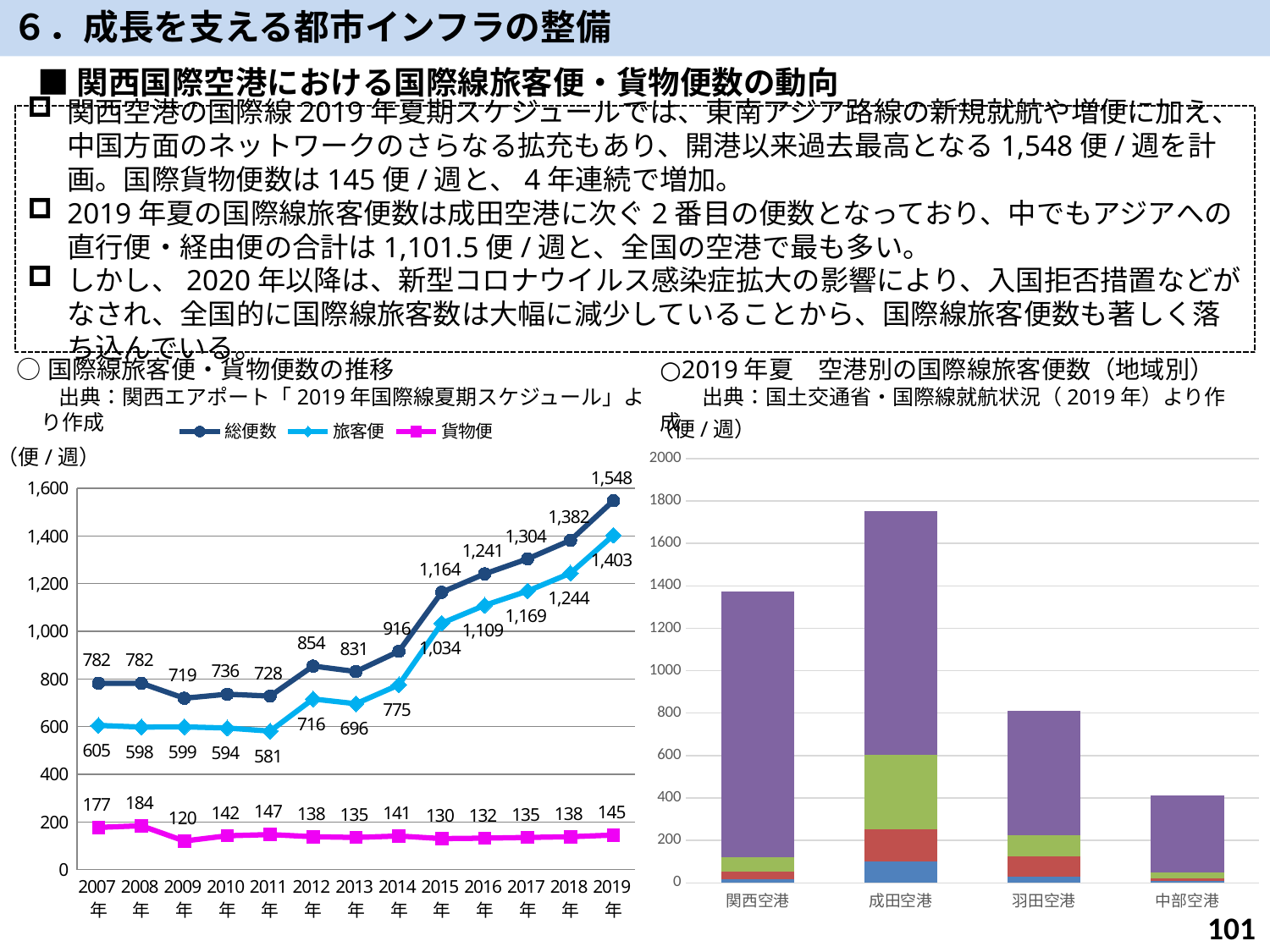
What kind of chart is the right chart (2019年夏 空港別の国際線旅客便数)? stacked bar chart In the left chart (国際線旅客便・貨物便数の推移), what is the value of 旅客便 in 2015年? 1,034 In the left chart (国際線旅客便・貨物便数の推移), how many series does the legend list? 3 In the right chart (2019年夏 空港別の国際線旅客便数), which airport has the tallest bar? 成田空港 In the left chart (国際線旅客便・貨物便数の推移), what is the difference between 総便数 in 2019年 and 2018年? 166 In the left chart (国際線旅客便・貨物便数の推移), in which year is 旅客便 lowest? 2011年 In the left chart (国際線旅客便・貨物便数の推移), in which year is 貨物便 highest? 2008年 In the left chart (国際線旅客便・貨物便数の推移), does 旅客便 rise or fall from 2014年 to 2019年? rise In the left chart (国際線旅客便・貨物便数の推移), what is the value of 総便数 in 2019年? 1,548 In the right chart (2019年夏 空港別の国際線旅客便数), is the total for 中部空港 greater or less than 600? less In the left chart (国際線旅客便・貨物便数の推移), what is the value of 貨物便 in 2009年? 120 In the left chart (国際線旅客便・貨物便数の推移), how many years are shown on the x axis? 13